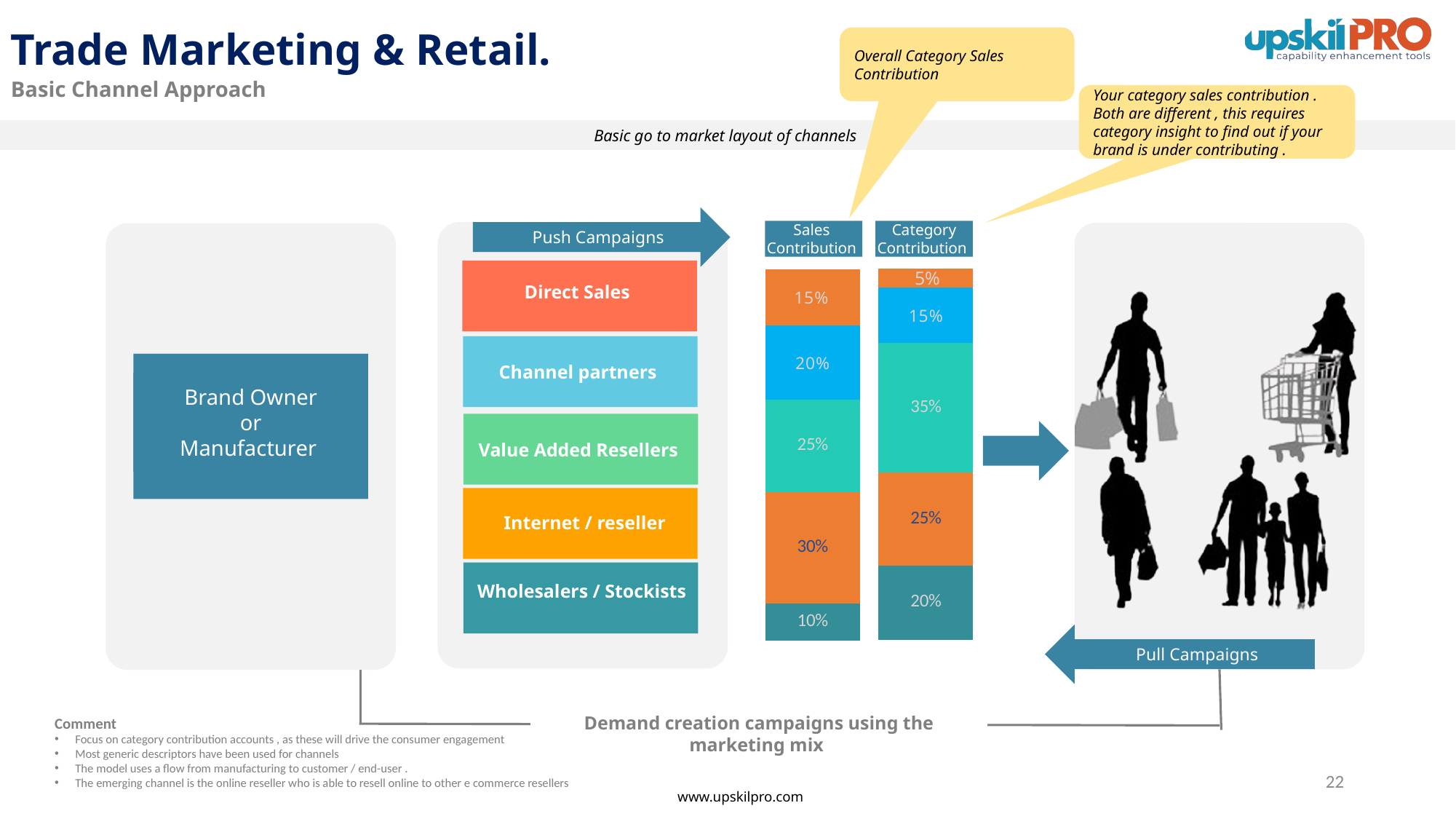
What is the difference between the Sales Contribution and Category Contribution values for the segment aligned with Value Added Resellers? 10% For the segment aligned with Internet / reseller, which is larger: the Sales Contribution value or the Category Contribution value? Sales Contribution (30%) What is the total of the segments in the Sales Contribution bar? 100% Which segment of the Category Contribution bar has the smallest value? 5% (the segment aligned with Direct Sales) In the Sales Contribution bar, what is the value of the bottom segment (aligned with Wholesalers / Stockists)? 10% In the Category Contribution bar, what is the value of the top segment (aligned with Direct Sales)? 5% What kind of chart is used to show Sales Contribution and Category Contribution? Stacked bar chart In the Sales Contribution bar, what is the value of the top segment (aligned with Direct Sales)? 15% Which segment of the Sales Contribution bar has the largest value? 30% (the segment aligned with Internet / reseller) In the Category Contribution bar, what is the value of the middle segment (aligned with Value Added Resellers)? 35% In the Category Contribution bar, what is the value of the bottom segment (aligned with Wholesalers / Stockists)? 20% How many segments does each stacked bar contain? 5